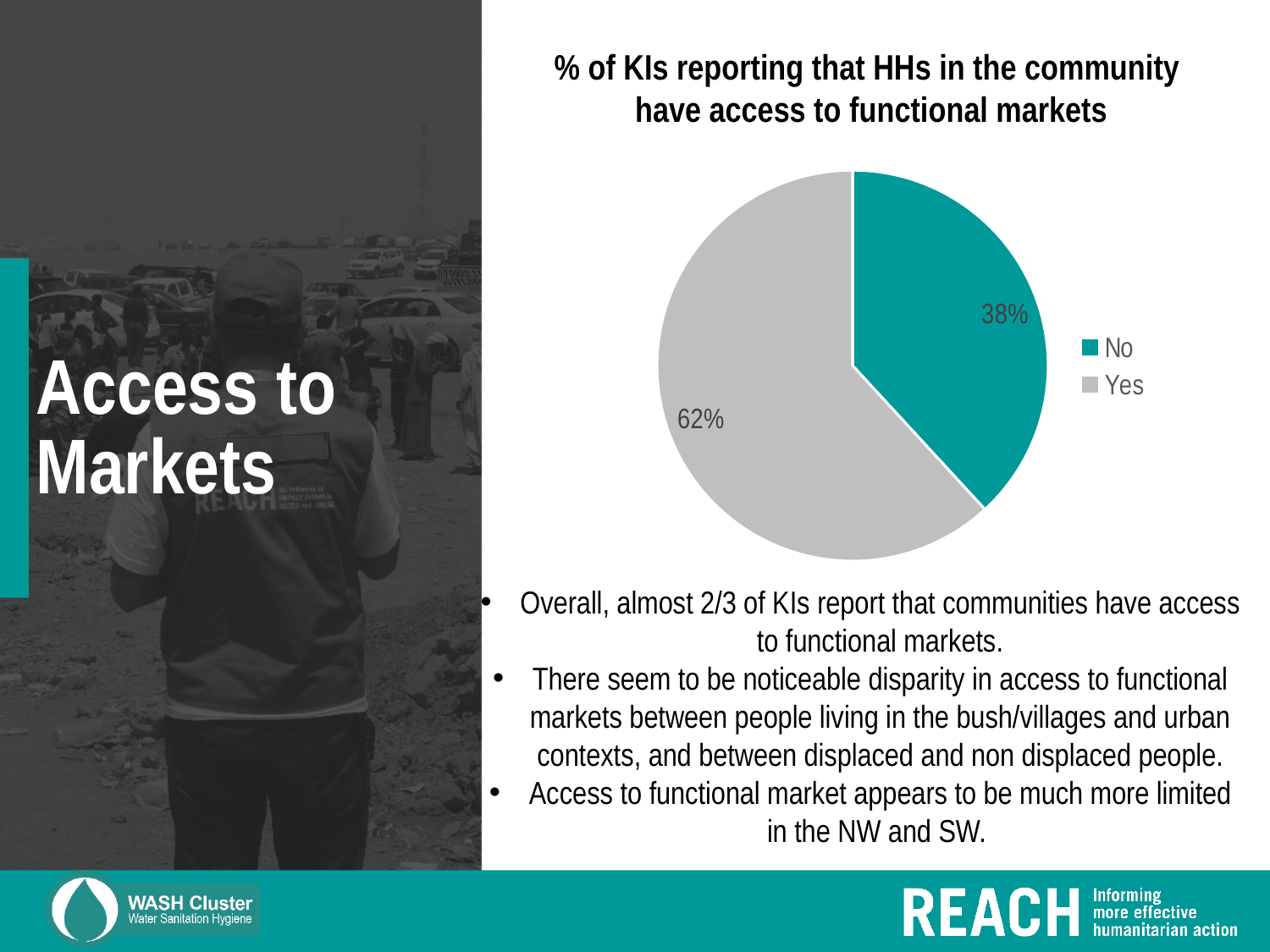
Which category has the smaller share of the pie? No How many entries does the legend list? 2 Is the 'No' slice larger or smaller than the 'Yes' slice? Smaller What percentage of KIs reported 'Yes' to HHs in the community having access to functional markets? 62% Which category has the larger share of the pie, 'Yes' or 'No'? Yes What percentage of KIs reported 'No' to HHs in the community having access to functional markets? 38% What is the title of the pie chart? % of KIs reporting that HHs in the community have access to functional markets How many categories does the pie chart show? 2 What is the difference in percentage points between the 'Yes' and 'No' slices? 24 What colour is the 'No' slice in the pie chart? Teal What is the total of the two slices shown in the pie chart? 100% What type of chart is shown on the slide? Pie chart